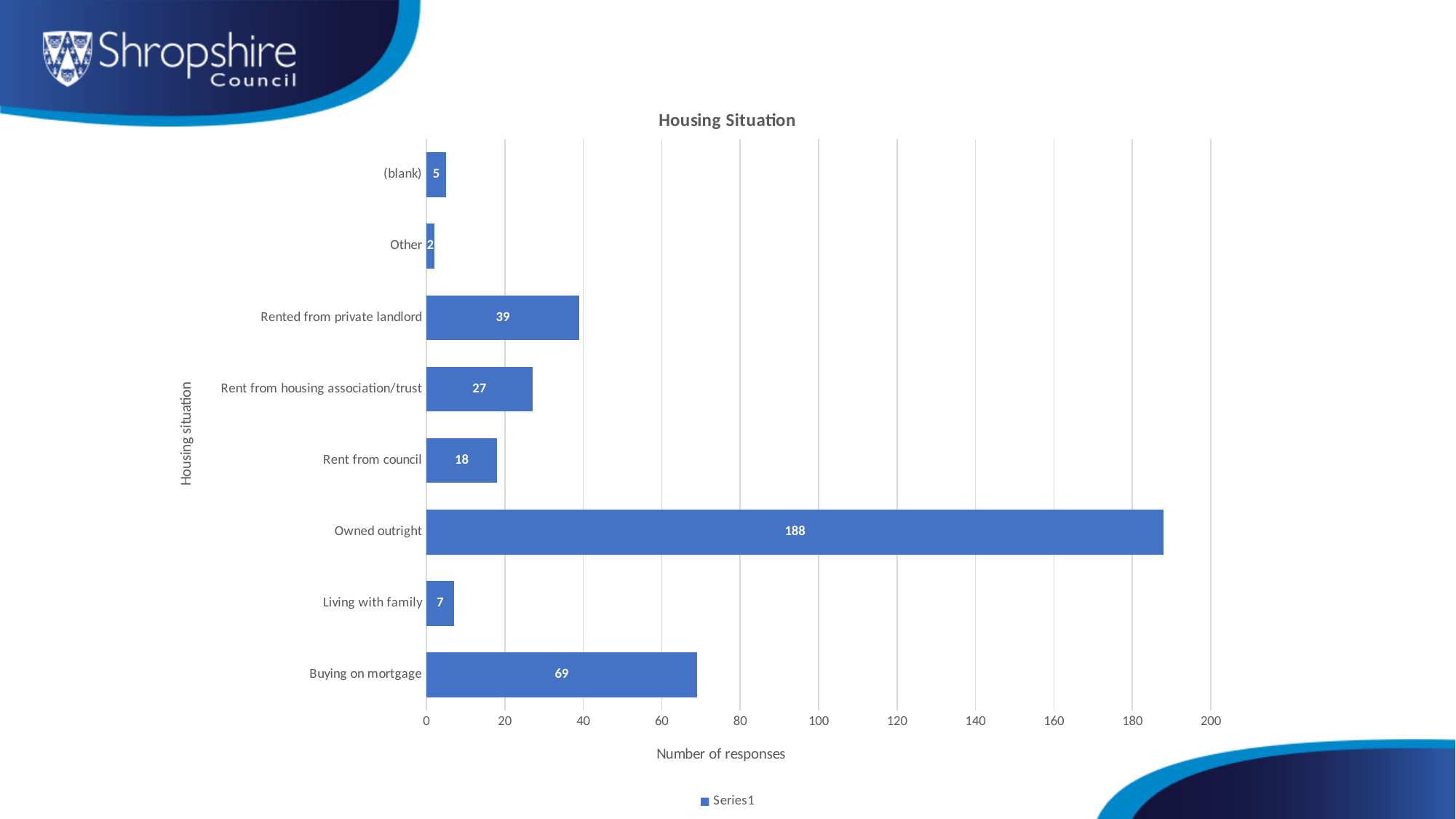
What is the number of responses for Living with family? 7 What is the number of responses for Rented from private landlord? 39 Which has more responses, Rent from council or Rent from housing association/trust? Rent from housing association/trust What is the number of responses for Owned outright? 188 What is the difference in responses between Rented from private landlord and Rent from housing association/trust? 12 Which housing situation has the lowest number of responses? Other How many housing situation categories are shown on the chart? 8 Which housing situation has the highest number of responses? Owned outright Is the value for Buying on mortgage greater or less than 60? greater What kind of chart is shown on the slide? Bar chart What is the title of the chart? Housing Situation What is the difference in responses between Owned outright and Buying on mortgage? 119